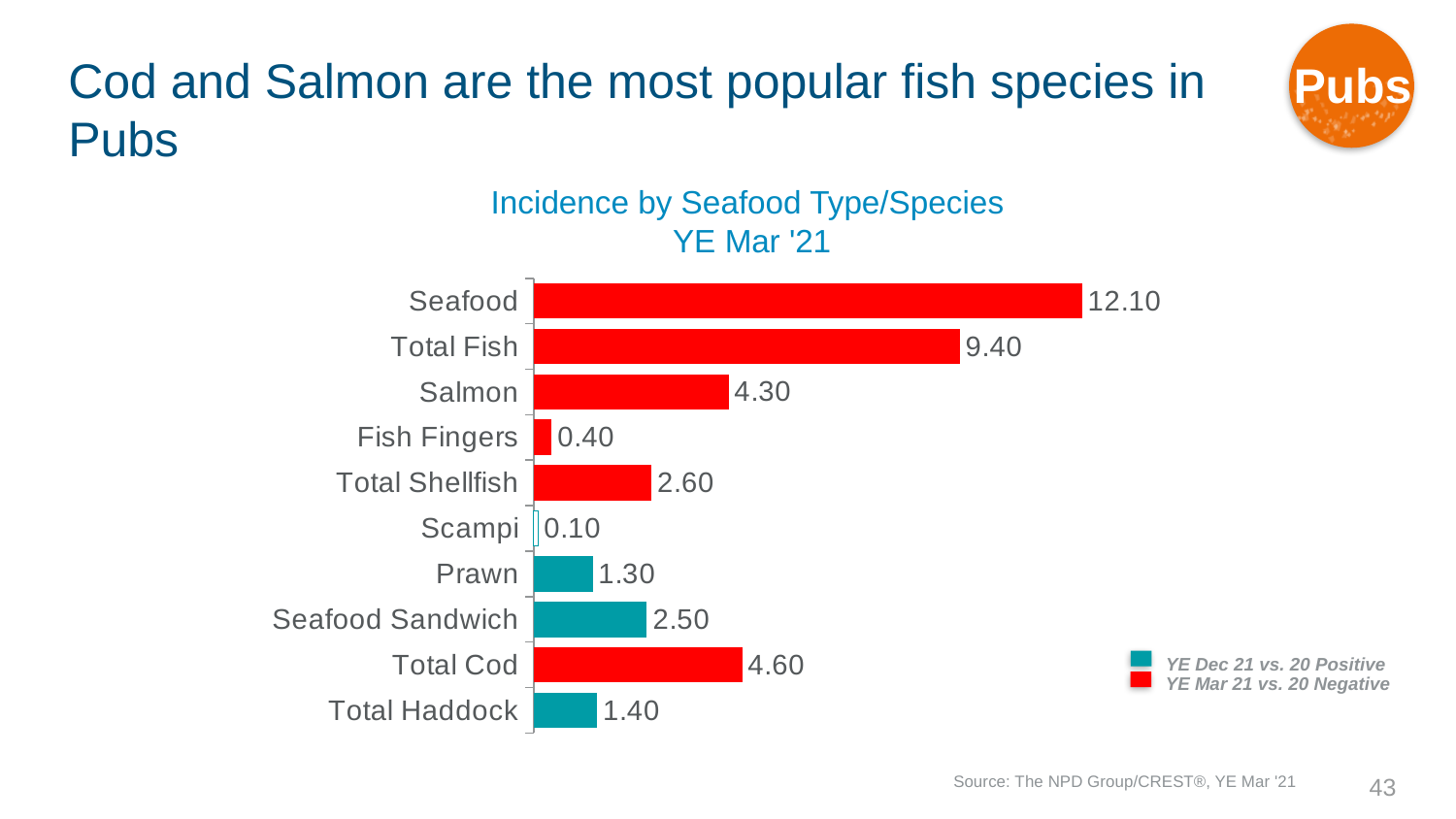
What is the value for Seafood? 12.10 Which is larger, the value for Prawn or the value for Total Haddock? Total Haddock What is the value for Total Cod? 4.60 Which is larger, the value for Salmon or the value for Total Cod? Total Cod What is the value for Scampi? 0.10 How many categories are shown in the chart? 10 How many series does the legend list? 2 What is the difference between the values for Seafood and Total Fish? 2.70 What is the title of the chart? Incidence by Seafood Type/Species YE Mar '21 Which category has the lowest value? Scampi What kind of chart is shown on the slide? Bar chart Which category has the highest value? Seafood